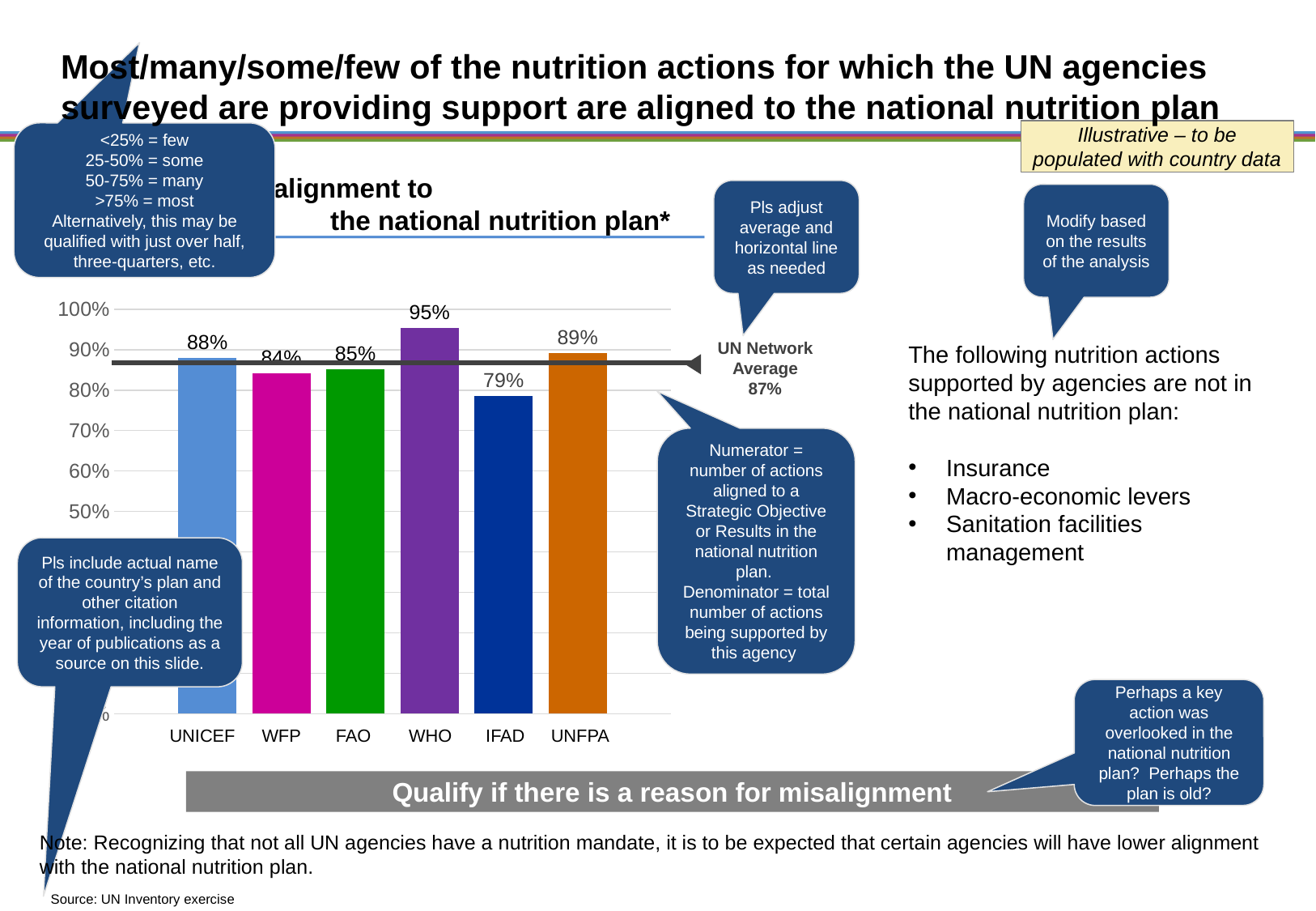
What is the UN Network Average shown by the horizontal line? 87% What kind of chart is shown on the slide? bar chart Is the value for IFAD greater or less than 80%? less Which agency has the lowest value? IFAD What is the value for IFAD? 79% Which is larger, the value for UNICEF or the value for FAO? UNICEF How many agencies are shown on the x axis? 6 What is the value for UNFPA? 89% What is the value for WHO? 95% What is the difference between the values for WHO and IFAD? 16% What is the value for UNICEF? 88% Which agency has the highest value? WHO